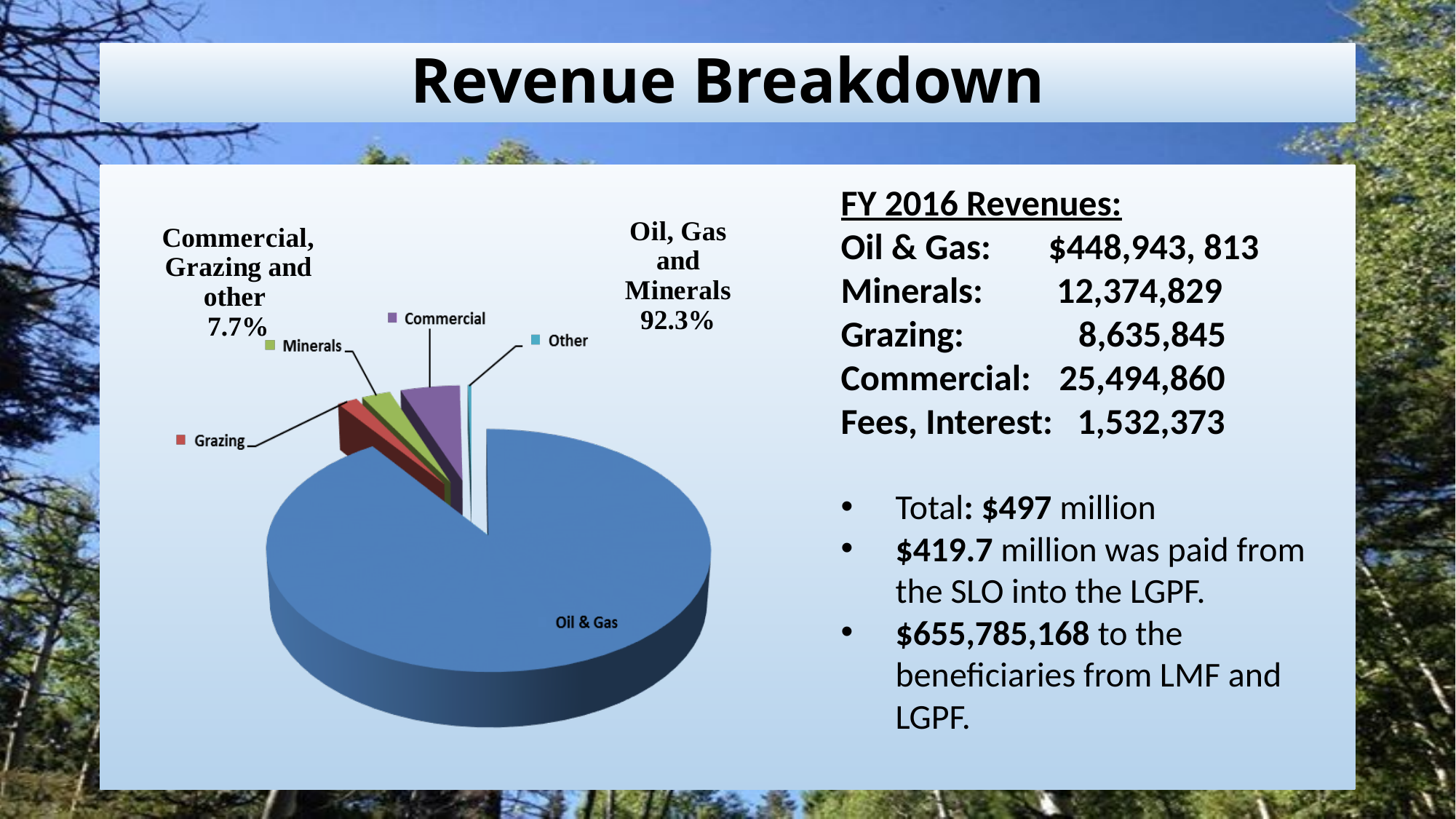
What colour is the Oil & Gas slice in the pie chart? blue What combined share of the pie do Oil, Gas and Minerals make up? 92.3% According to the FY 2016 revenue figures on the slide, what was the Commercial revenue? 25,494,860 How many slices does the pie chart have? 5 What is the title of the slide containing the pie chart? Revenue Breakdown Which slice is larger in the pie chart, Oil & Gas or Commercial? Oil & Gas What kind of chart is shown on the slide? pie chart What combined share of the pie do Commercial, Grazing and other make up? 7.7% Which slice of the pie chart is the smallest? Other Which slice of the pie chart is the largest? Oil & Gas According to the FY 2016 revenue figures on the slide, what was the Oil & Gas revenue? $448,943, 813 Which slice is larger in the pie chart, Commercial or Grazing? Commercial